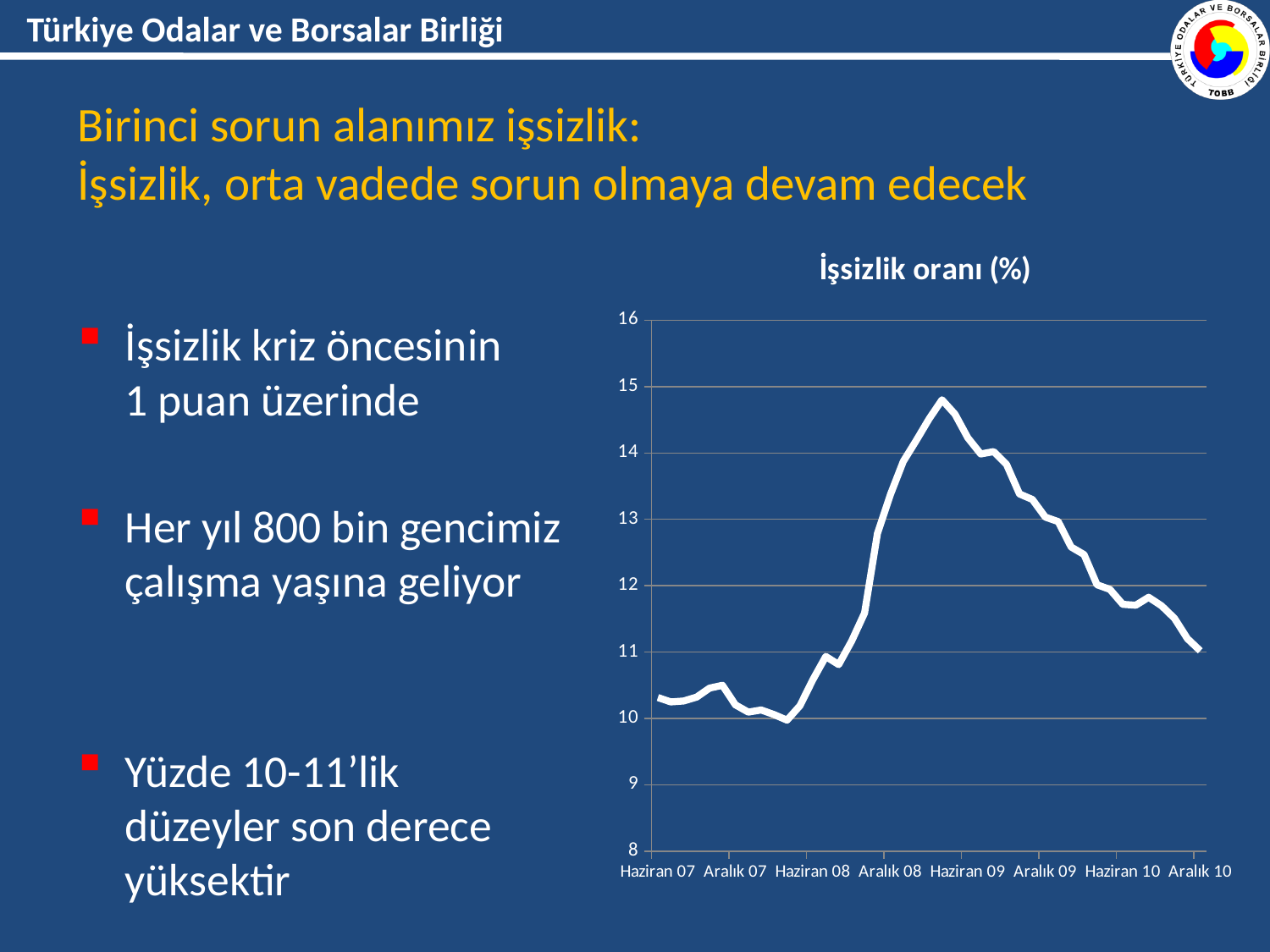
What kind of chart is shown on the slide? line chart How many labels are shown on the x axis of the chart? 8 Does the unemployment rate rise or fall between Haziran 09 and Aralık 10? fall Is the highest point on the line greater or less than 15? less Is the value for Haziran 09 greater or less than 14? greater Is the value for Haziran 10 greater or less than 13? less Which is higher, the value for Haziran 09 or the value for Aralık 10? Haziran 09 What is the title of the chart? İşsizlik oranı (%)